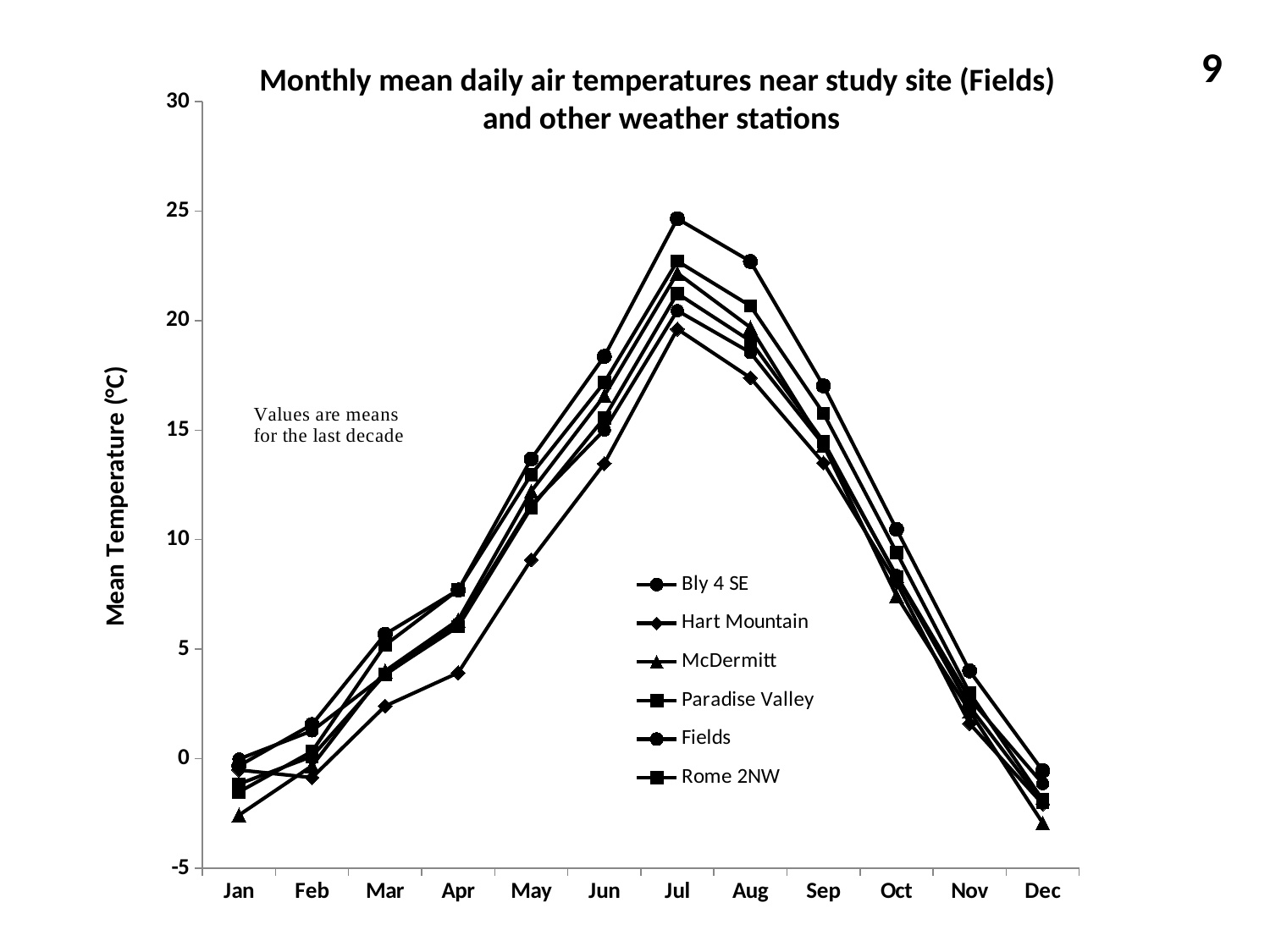
In July, which station has the higher mean temperature, Hart Mountain or McDermitt? McDermitt Is the mean temperature for Hart Mountain in May greater or less than 10? less Which station has the lowest mean temperature in January? McDermitt How many weather stations (series) does the legend list? 6 What is the label of the y axis? Mean Temperature (°C) Which station has the lowest mean temperature in July? Hart Mountain In which month do the temperatures for all stations reach their highest values? Jul Which station has the lowest mean temperature in December? McDermitt How many months are plotted along the x axis? 12 Is the mean temperature for McDermitt in January greater or less than 0? less Do the mean temperatures rise or fall from July to December? fall What kind of chart is shown on the slide? line chart